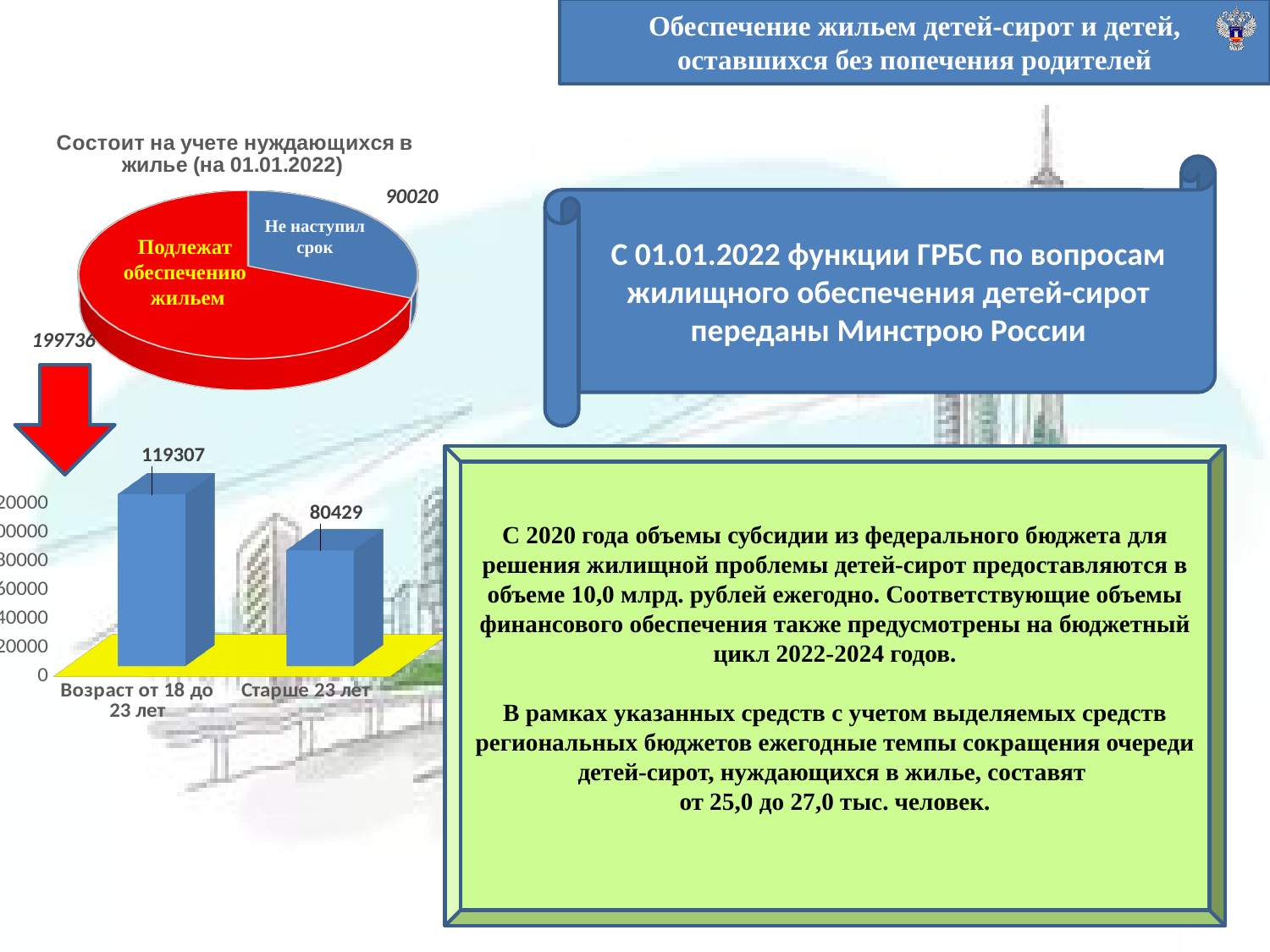
In the bar chart at the bottom left of the slide, what is the value for 'Возраст от 18 до 23 лет'? 119307 What kind of chart is the chart at the top left of the slide? Pie chart In the pie chart 'Состоит на учете нуждающихся в жилье (на 01.01.2022)', what is the value for 'Подлежат обеспечению жильем'? 199736 In the pie chart 'Состоит на учете нуждающихся в жилье (на 01.01.2022)', what is the difference between 'Подлежат обеспечению жильем' and 'Не наступил срок'? 109716 In the pie chart 'Состоит на учете нуждающихся в жилье (на 01.01.2022)', what is the value for 'Не наступил срок'? 90020 In the bar chart at the bottom left of the slide, is the value for 'Старше 23 лет' greater or less than 40000? greater In the bar chart at the bottom left of the slide, what is the value for 'Старше 23 лет'? 80429 What kind of chart is the chart at the bottom left of the slide? Bar chart In the pie chart 'Состоит на учете нуждающихся в жилье (на 01.01.2022)', which slice is the largest? Подлежат обеспечению жильем In the bar chart at the bottom left of the slide, which category has the lowest value? Старше 23 лет In the pie chart 'Состоит на учете нуждающихся в жилье (на 01.01.2022)', how many slices are there? 2 In the bar chart at the bottom left of the slide, what is the difference between 'Возраст от 18 до 23 лет' and 'Старше 23 лет'? 38878